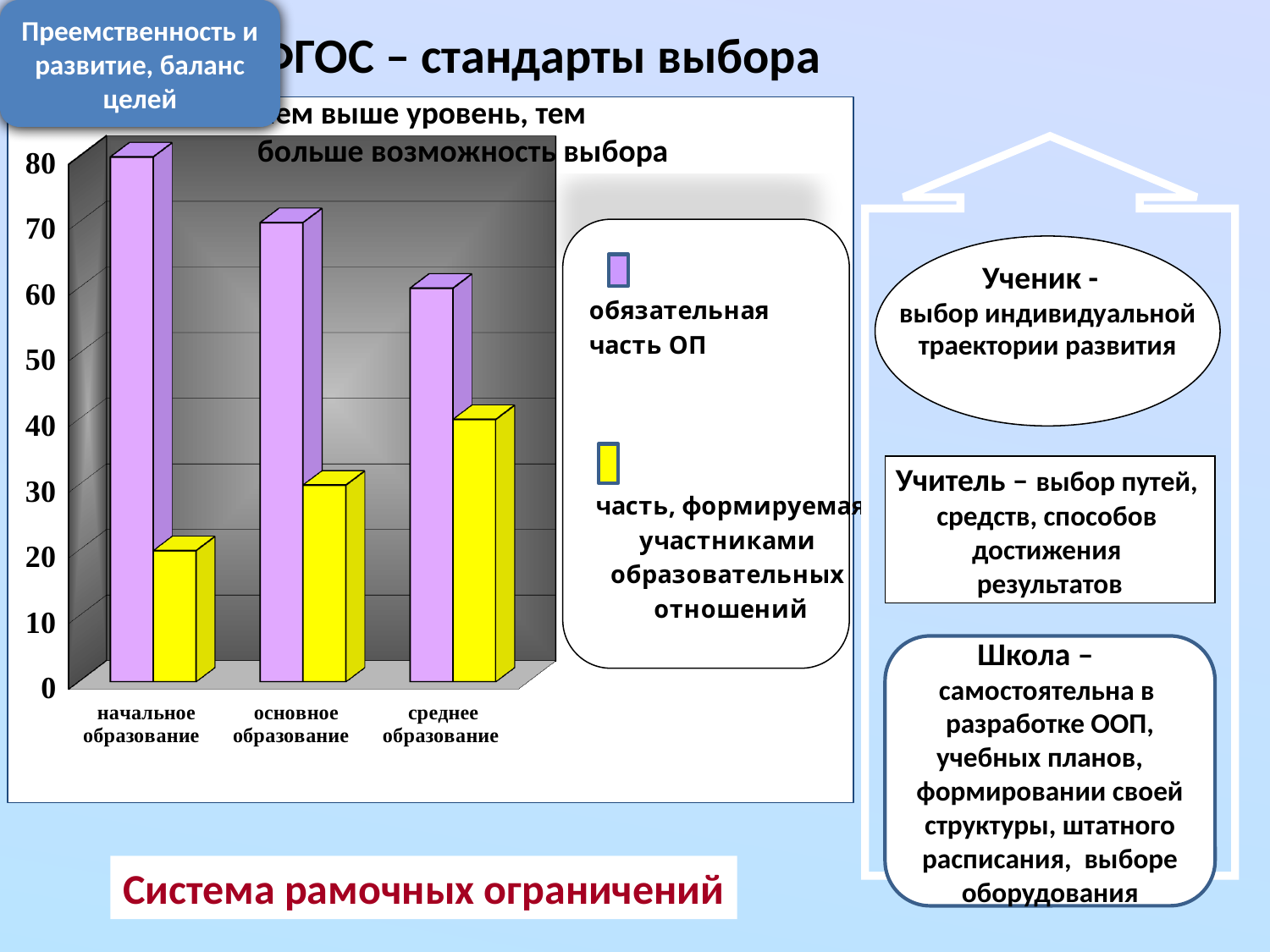
Which is larger for среднее образование: обязательная часть ОП or часть, формируемая участниками образовательных отношений? обязательная часть ОП Is the value of часть, формируемая участниками образовательных отношений for основное образование greater or less than 50? less How many series does the chart legend list? 2 What is the value of обязательная часть ОП for основное образование? 70 What is the value of обязательная часть ОП for начальное образование? 80 For which category is обязательная часть ОП the highest? начальное образование What is the value of часть, формируемая участниками образовательных отношений for среднее образование? 40 Does обязательная часть ОП rise or fall from начальное образование to среднее образование? fall How many categories are shown on the x axis of the chart? 3 What colour are the bars for обязательная часть ОП in the chart? purple What kind of chart is shown on the slide? bar chart For which category is часть, формируемая участниками образовательных отношений the lowest? начальное образование